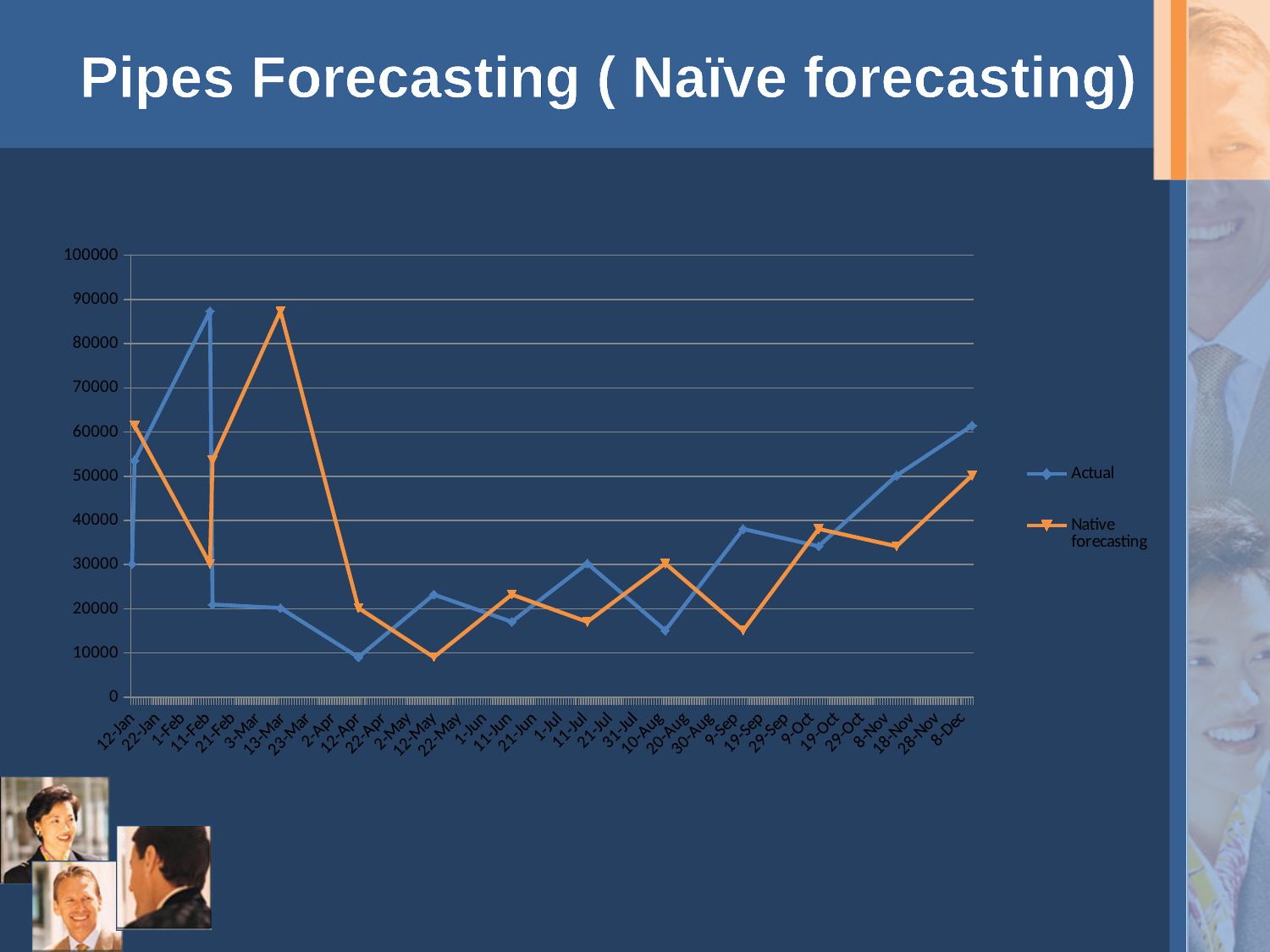
What kind of chart is shown on the slide? Line chart What are the two series named in the legend? Actual and Native forecasting What is the first date label on the horizontal axis? 12-Jan What is the highest value shown on the vertical axis? 100000 What is the last date label on the horizontal axis? 8-Dec Is the peak value of the Actual series greater or less than 80000? greater How many series does the legend list? 2 Is the peak value of the Native forecasting series greater or less than 80000? greater Is the final value of the Actual series, at the right end of the chart, greater or less than 50000? greater Over the last several points toward 8-Dec, does the Actual series rise or fall? Rise Which colour is used for the Native forecasting series? Orange At the right end of the chart, which series has the larger value, Actual or Native forecasting? Actual